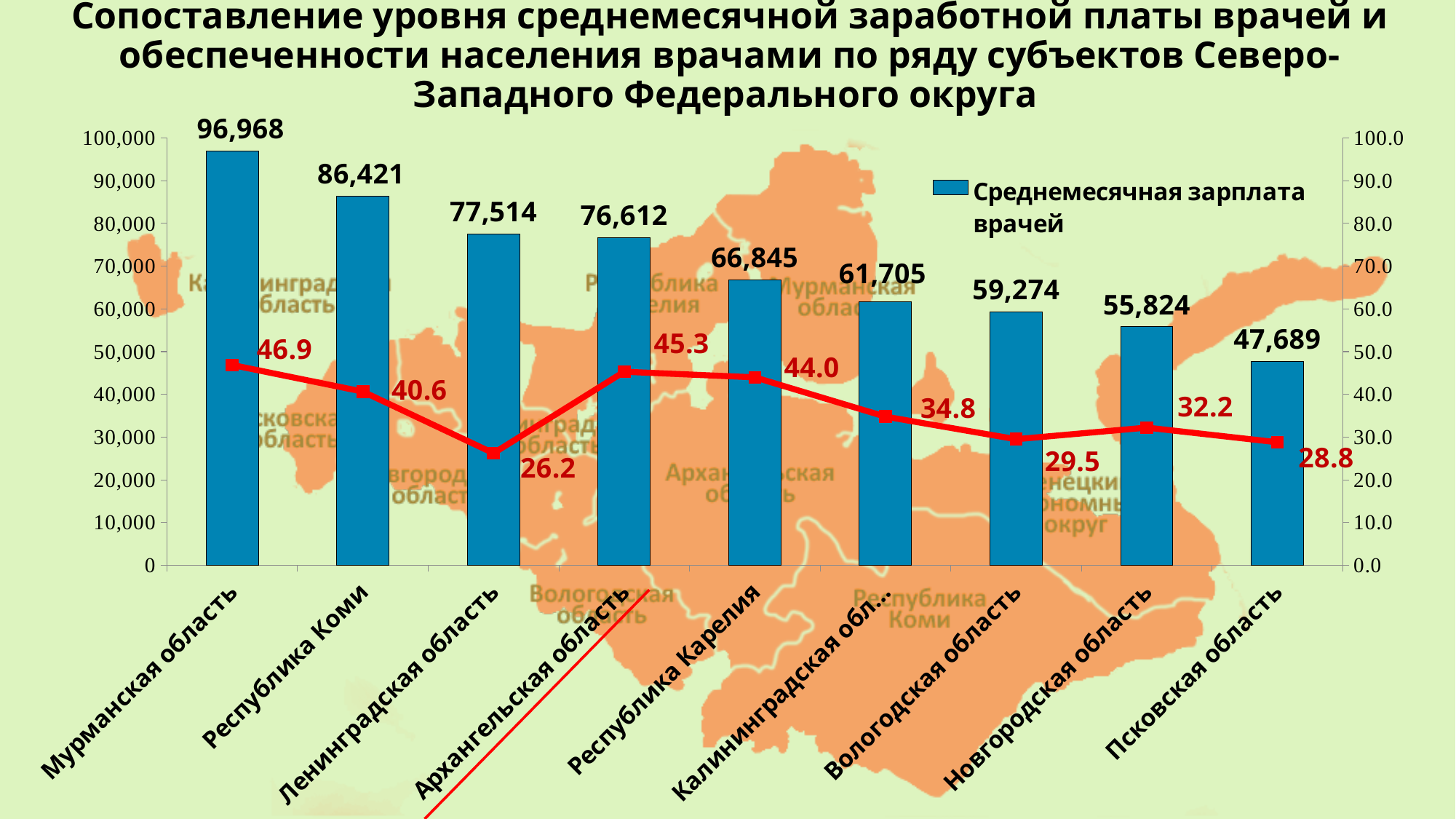
What series name is listed in the chart legend? Среднемесячная зарплата врачей How many regions are shown on the x axis of the chart? 9 What is the average monthly salary of doctors (Среднемесячная зарплата врачей) in Мурманская область? 96,968 Which region has the lowest average monthly salary of doctors? Псковская область What is the average monthly salary of doctors shown for Республика Карелия? 66,845 What is the difference between the average monthly salary of doctors in Мурманская область and in Псковская область? 49,279 Which region has the highest average monthly salary of doctors? Мурманская область Which has a higher red-line value: Архангельская область or Вологодская область? Архангельская область Which region has the lowest value on the red line? Ленинградская область Do the bar values rise or fall from left to right along the x axis? fall What value does the red line show for Новгородская область? 32.2 What value does the red line show for Ленинградская область? 26.2